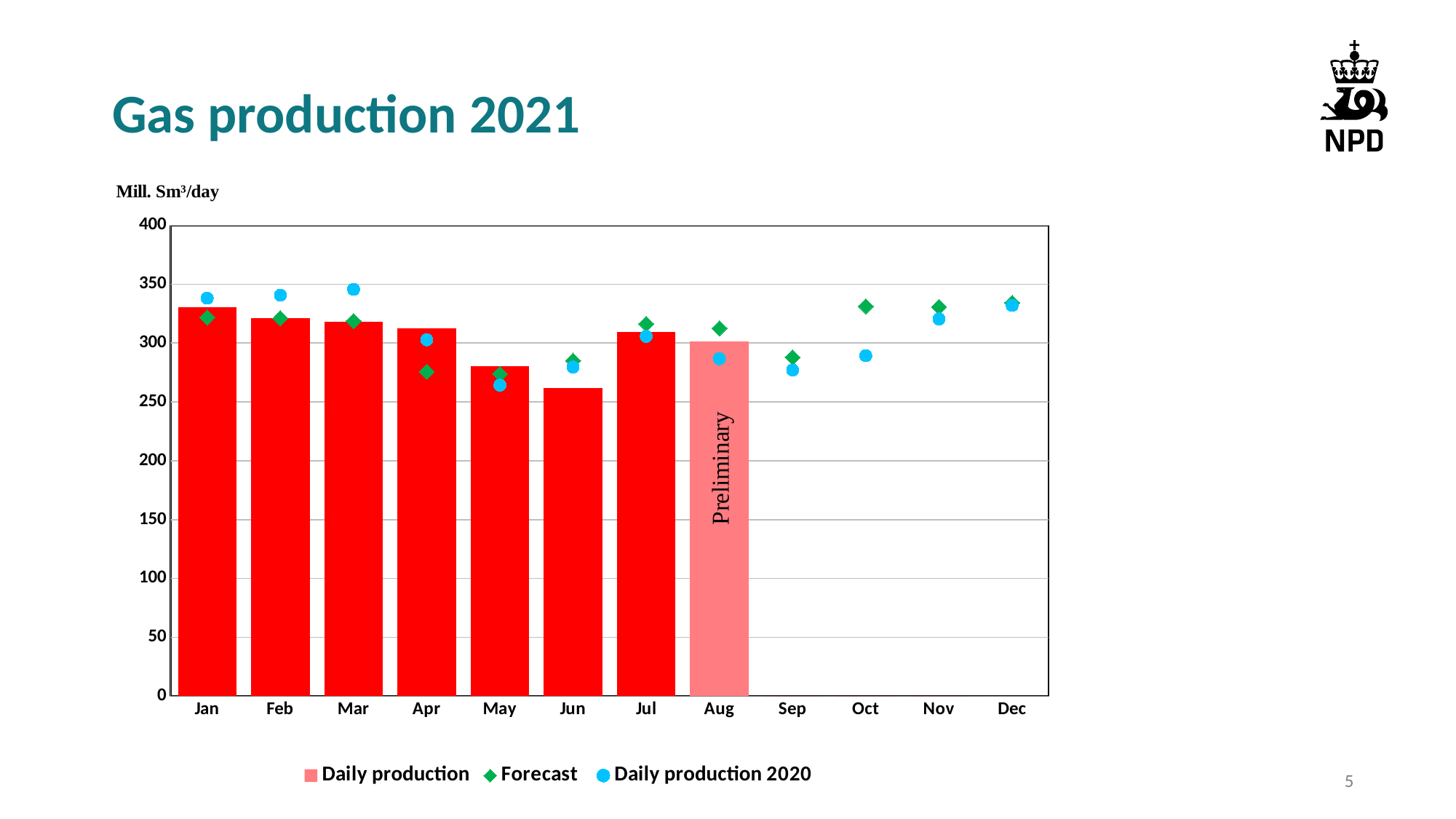
Which is larger, the Daily production bar for Jan or for Jun? Jan Which month has the highest Daily production bar? Jan How many series does the legend list? 3 Is the Daily production value for Jan greater or less than 300? greater Which month has the lowest Daily production bar? Jun Do the Daily production bars rise or fall from Jan to Jun? Fall Is the Daily production value for Jun greater or less than 300? less How many months are shown on the x axis? 12 What kind of chart is shown on the slide? Combination bar and line chart (bars with markers) Is the Daily production 2020 value for May greater or less than 300? less How many Daily production bars are plotted? 8 What label is written on the Aug bar? Preliminary